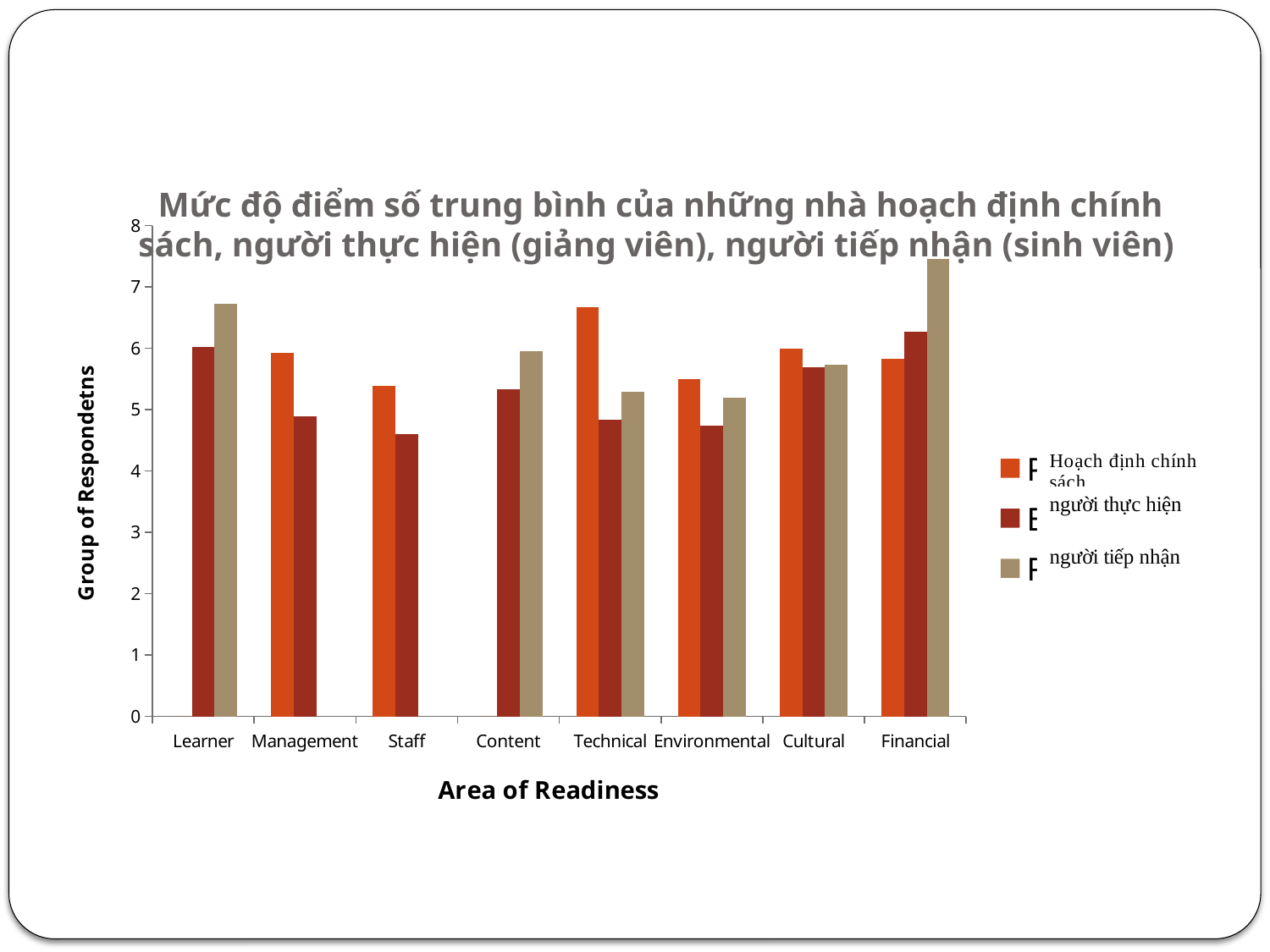
What is the title of the x axis? Area of Readiness Is the value for 'người thực hiện' in the Environmental category greater or less than 5? less In which category is the 'Hoạch định chính sách' series highest? Technical Is the value for 'người thực hiện' in the Staff category greater or less than 5? less What is the title of the y axis? Group of Respondetns Which category has the highest bar in the whole chart? Financial In the Learner category, which is larger: 'người thực hiện' or 'người tiếp nhận'? người tiếp nhận Is the value for 'Hoạch định chính sách' in the Technical category greater or less than 6? greater What kind of chart is shown on the slide? bar chart How many categories are shown on the x axis of the chart? 8 How many series does the chart's legend list? 3